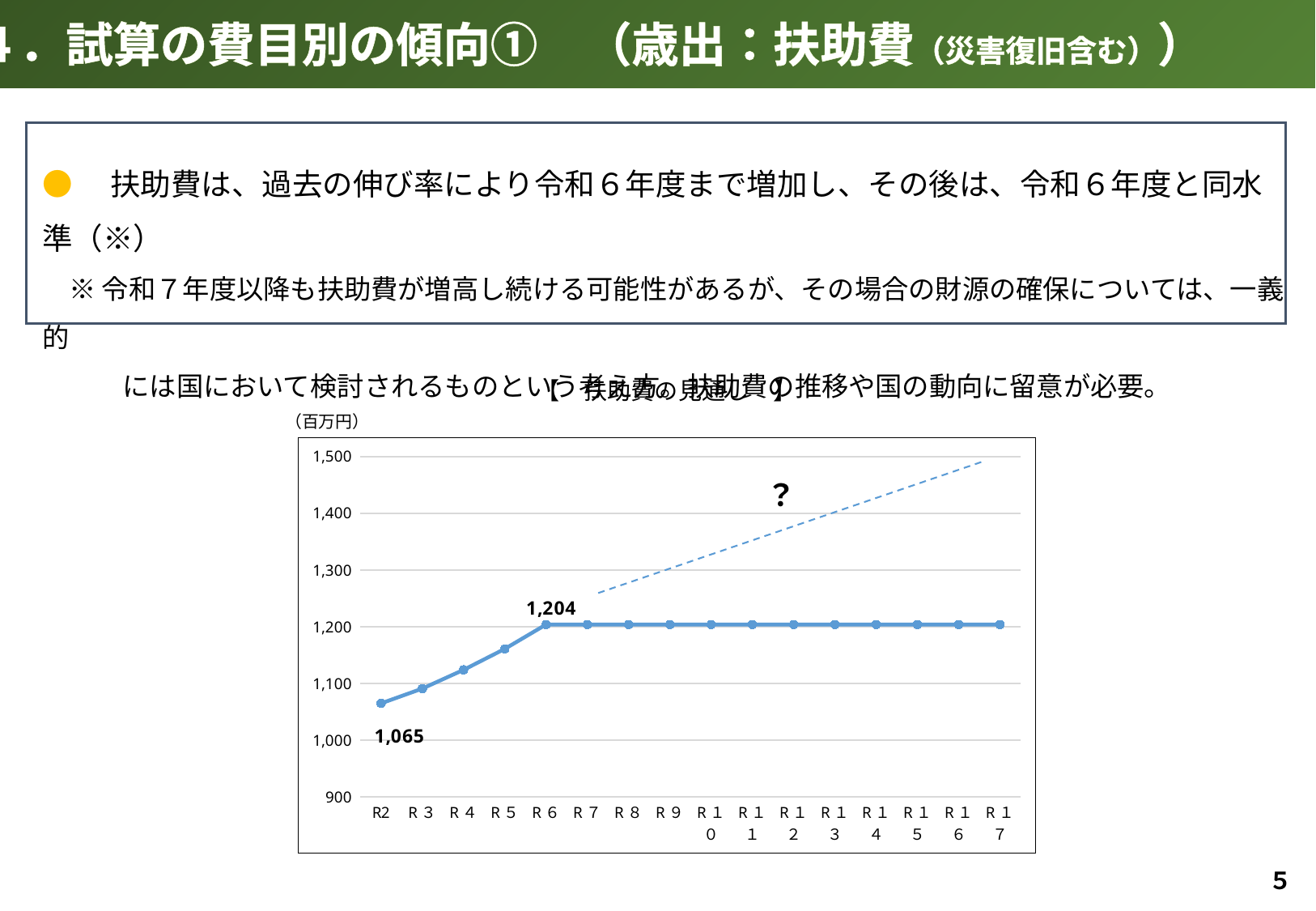
Which is larger, the value for R2 or the value for R6? R6 What unit is shown above the chart's vertical axis? 百万円 Do the values rise, fall or stay flat from R6 to R17? stay flat What kind of chart is shown on the slide? line chart How many years are plotted on the x axis? 16 Which year has the lowest value on the chart? R2 Do the values rise or fall from R2 to R6? rise Is the value for R4 greater or less than 1,100? greater What is the value for R2? 1,065 What is the value for R6? 1,204 What is the difference between the values for R6 and R2? 139